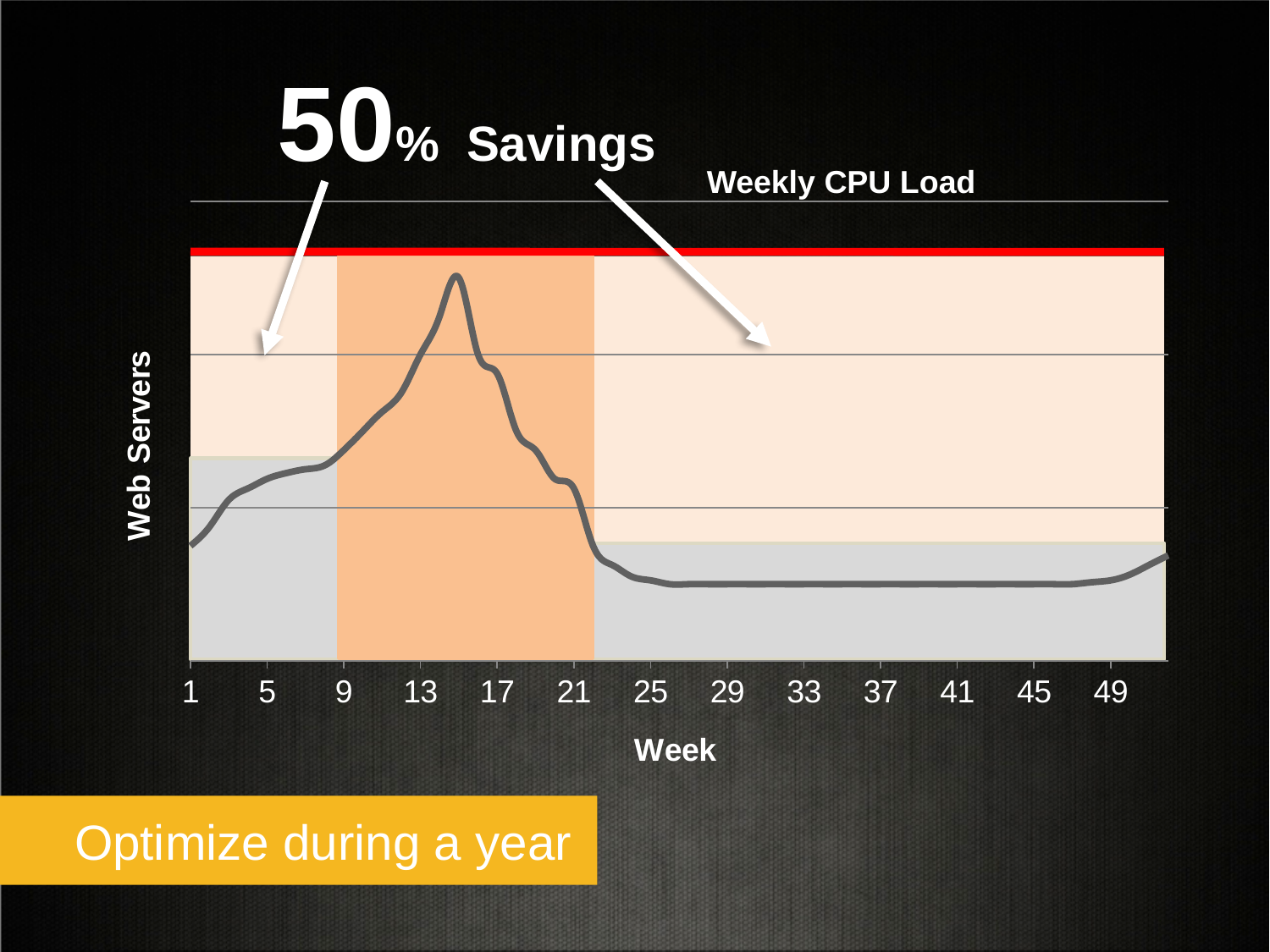
What is the label of the x axis? Week What is the title of the chart? Weekly CPU Load Does the line rise or fall between week 9 and week 15? rise Which is larger, the value at week 5 or the value at week 29? week 5 What is the last tick label shown on the x axis? 49 How many tick labels are shown on the x axis? 13 What is the label of the y axis? Web Servers Does the line rise or fall between week 15 and week 23? fall Is the value at week 15 larger or smaller than the value at week 33? larger Does the line reach its highest point before or after week 25? before What percentage of savings is stated above the chart? 50% What kind of chart is shown on the slide? line chart